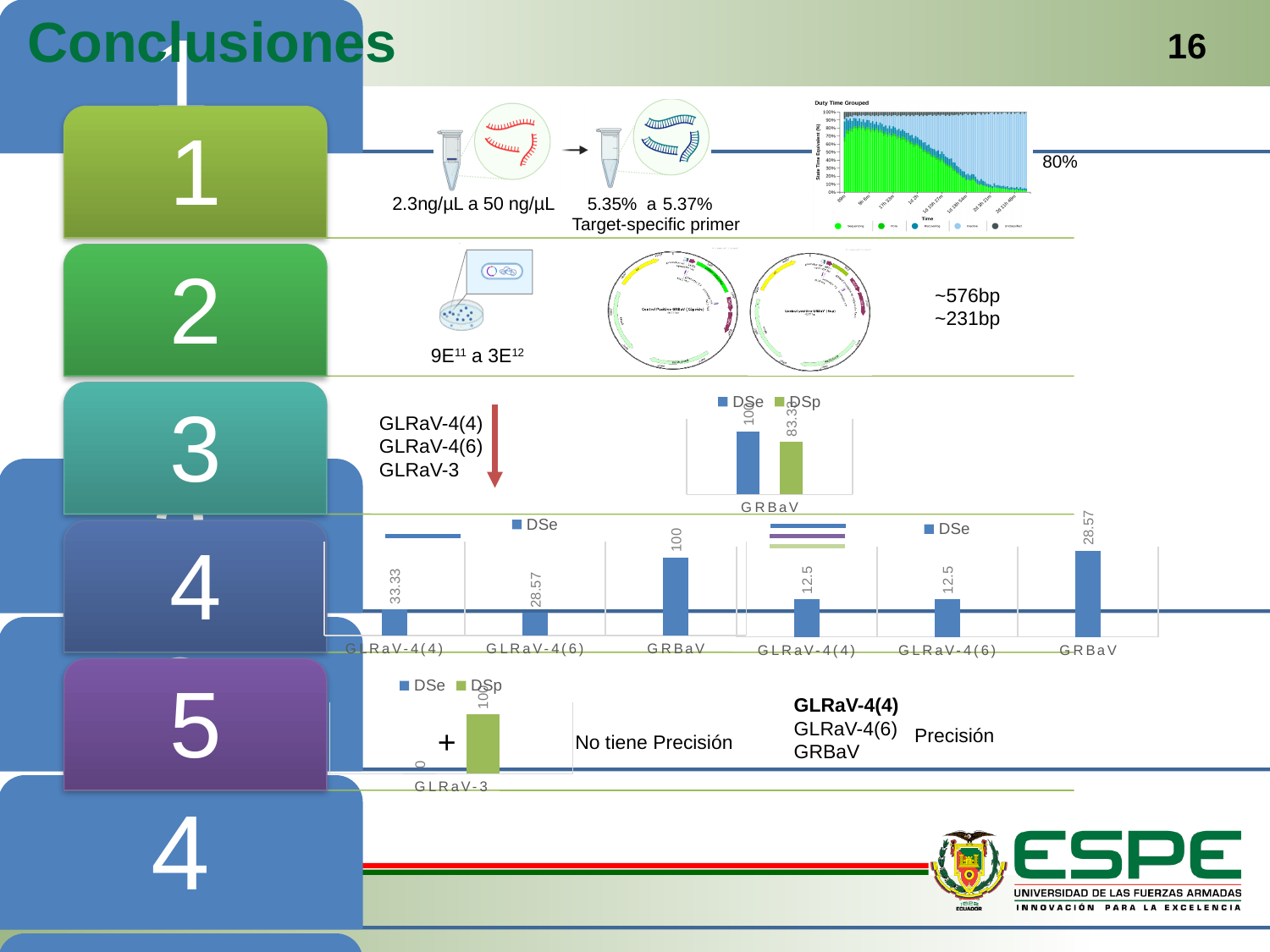
In the right chart of row 4 (DSe only), what is the value for GLRaV-4(6)? 12.5 In the right chart of row 4 (DSe only), what is the value for GRBaV? 28.57 In the left chart of row 4 (DSe only), which category has the highest value? GRBaV In the chart in row 3 (legend DSe and DSp, category GRBaV), what is the difference between the DSe and DSp values? 16.67 In the chart in row 3 (legend DSe and DSp, category GRBaV), what is the DSp value for GRBaV? 83.33 In the chart in row 5 (category GLRaV-3), what is the DSp value? 100 In the left chart of row 4 (DSe only), how many categories are plotted? 3 In the right chart of row 4 (DSe only), what is the difference between the GRBaV value and the GLRaV-4(4) value? 16.07 In the left chart of row 4 (DSe only), what is the value for GLRaV-4(4)? 33.33 In the chart in row 3 (legend DSe and DSp, category GRBaV), what is the DSe value for GRBaV? 100 In the left chart of row 4 (DSe only), what is the value for GLRaV-4(6)? 28.57 In the chart in row 3 (legend DSe and DSp, category GRBaV), how many series does the legend list? 2